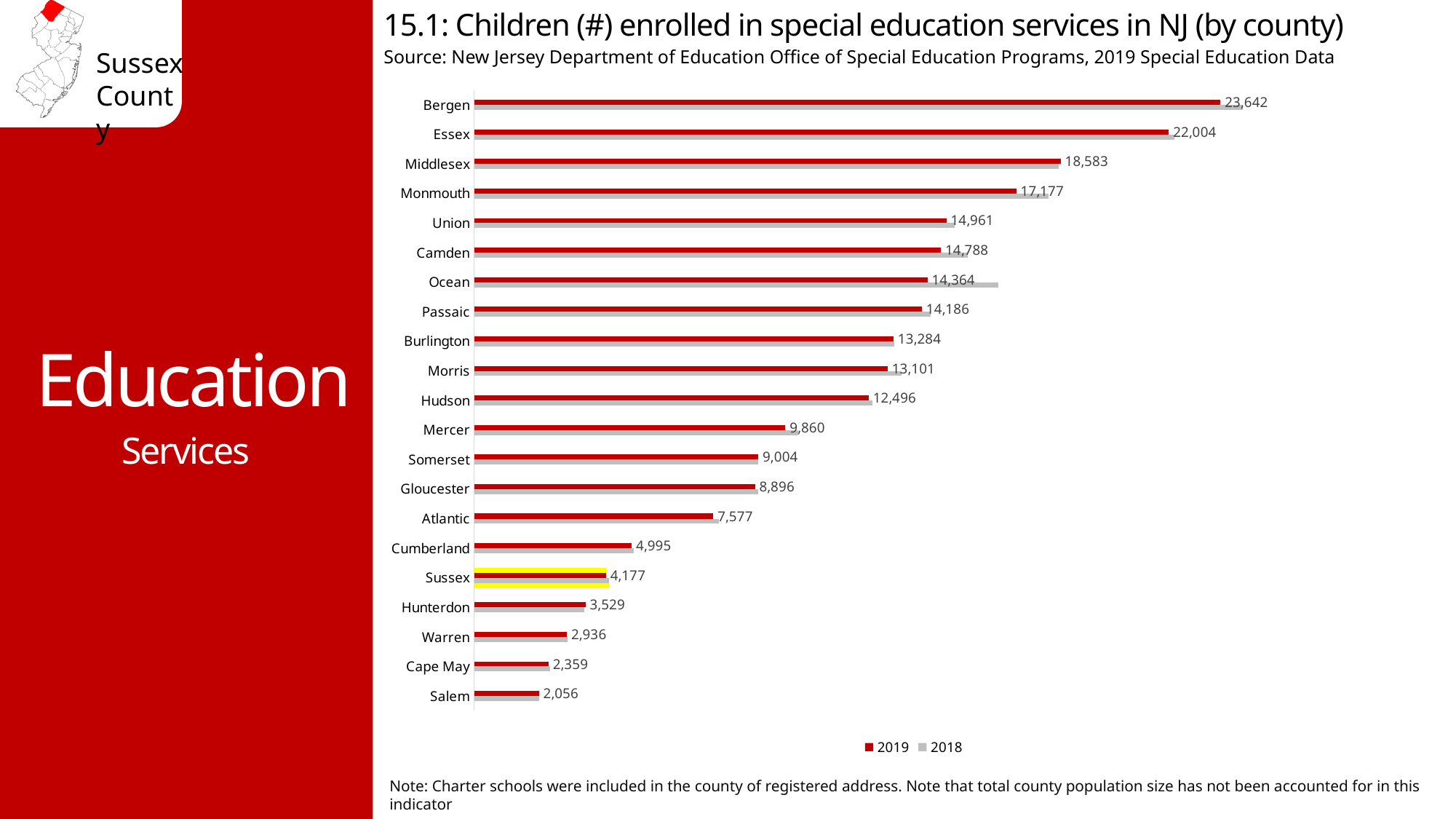
Which has the larger 2019 value, Burlington or Morris? Burlington What kind of chart is this? Bar chart How many series does the legend list? 2 Which county has the highest 2019 value? Bergen What is the 2019 value for Cumberland? 4,995 What is the 2019 value for Bergen? 23,642 What is the difference between the 2019 values for Sussex and Hunterdon? 648 What is the difference between the 2019 values for Bergen and Essex? 1,638 Which county has the lowest 2019 value? Salem For Ocean, which year has the larger value, 2018 or 2019? 2018 How many counties are shown on the chart? 21 What is the 2019 value for Sussex? 4,177